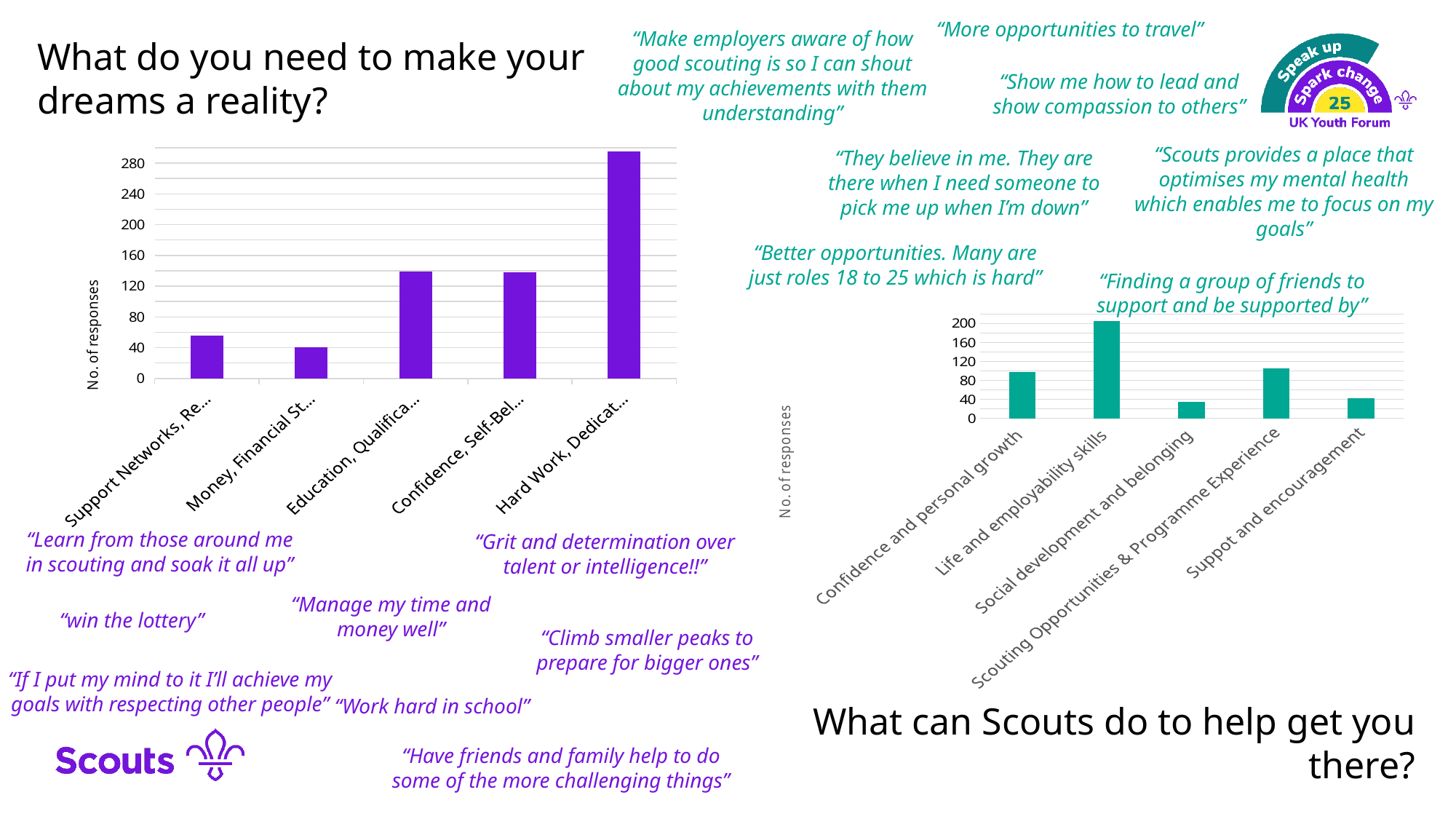
In the left chart, is the value for Money, Financial St... greater or less than 80? less What is the y-axis label of the left chart? No. of responses In the left chart, which category has the highest number of responses? Hard Work, Dedicat... In the left chart, is the value for Hard Work, Dedicat... greater or less than 280? greater In the left chart, which category has the lowest number of responses? Money, Financial St... What kind of chart is the left chart on the slide? bar chart How many categories does the left chart show? 5 In the right chart, which category has the highest number of responses? Life and employability skills In the left chart, which has more responses: Support Networks, Re... or Money, Financial St...? Support Networks, Re... In the right chart, which has more responses: Life and employability skills or Confidence and personal growth? Life and employability skills In the right chart, is the value for Social development and belonging greater or less than 80? less How many categories does the right chart show? 5